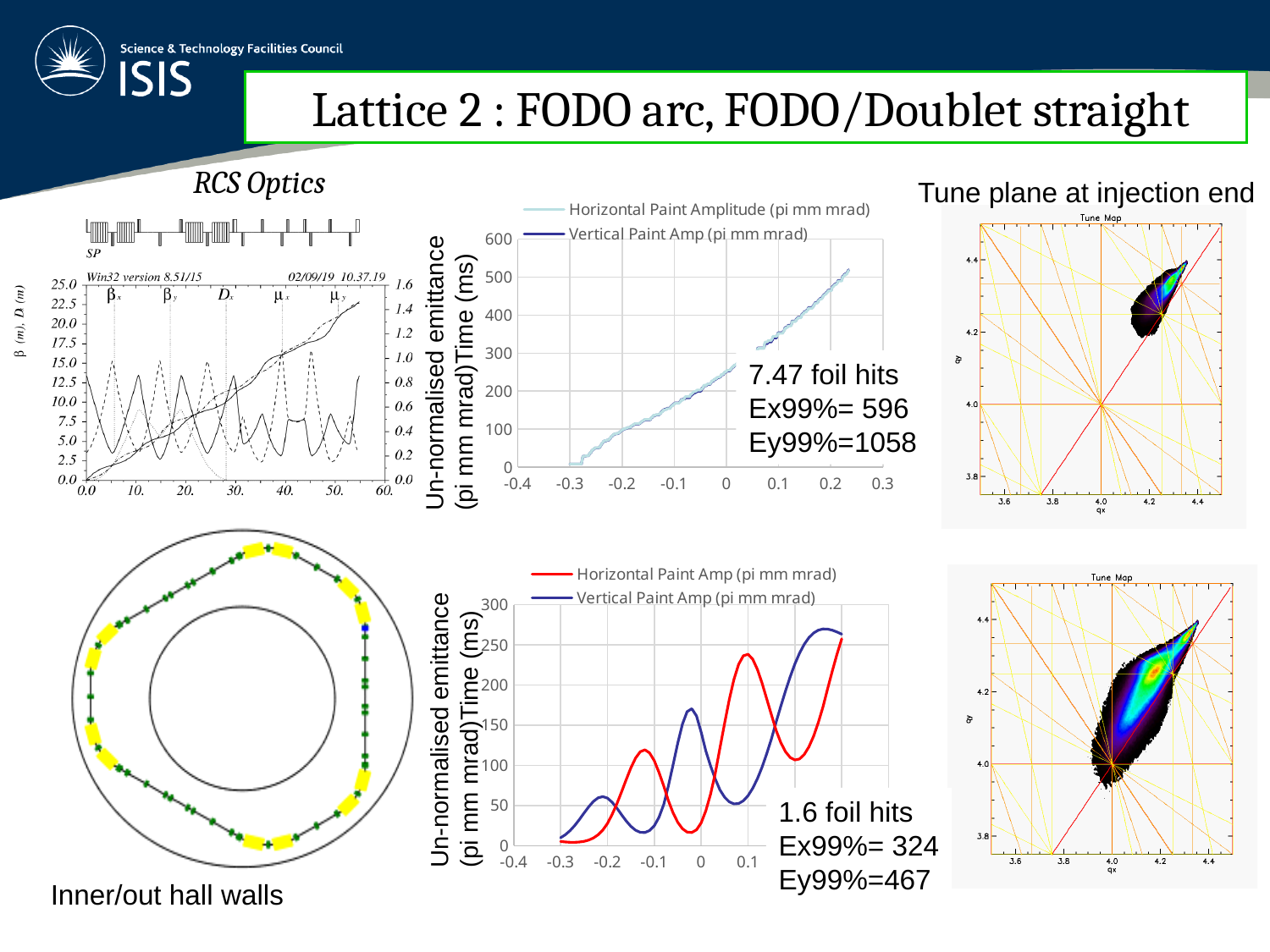
What is the highest tick value on the y axis of the lower middle paint amplitude chart? 300 What are the two legend entries of the upper middle paint amplitude chart? Horizontal Paint Amplitude (pi mm mrad) and Vertical Paint Amp (pi mm mrad) How many series does the legend of the upper middle paint amplitude chart list? 2 What kind of chart is the upper middle chart with the legend 'Horizontal Paint Amplitude (pi mm mrad)'? line chart In the upper middle paint amplitude chart, is the Horizontal Paint Amplitude at x = 0.2 greater or less than 400? greater In the upper middle paint amplitude chart, is the Horizontal Paint Amplitude at x = -0.2 greater or less than 200? less What is the lowest tick value on the x axis of the upper middle paint amplitude chart? -0.4 In the lower middle paint amplitude chart, is the Vertical Paint Amp at x = 0.1 greater or less than 200? less How many series does the legend of the lower middle paint amplitude chart list? 2 In the upper middle paint amplitude chart, do the values rise or fall as the x axis increases from -0.3 to 0.2? rise In the lower middle paint amplitude chart, at x = -0.2, which series is larger: Horizontal Paint Amp or Vertical Paint Amp? Vertical Paint Amp